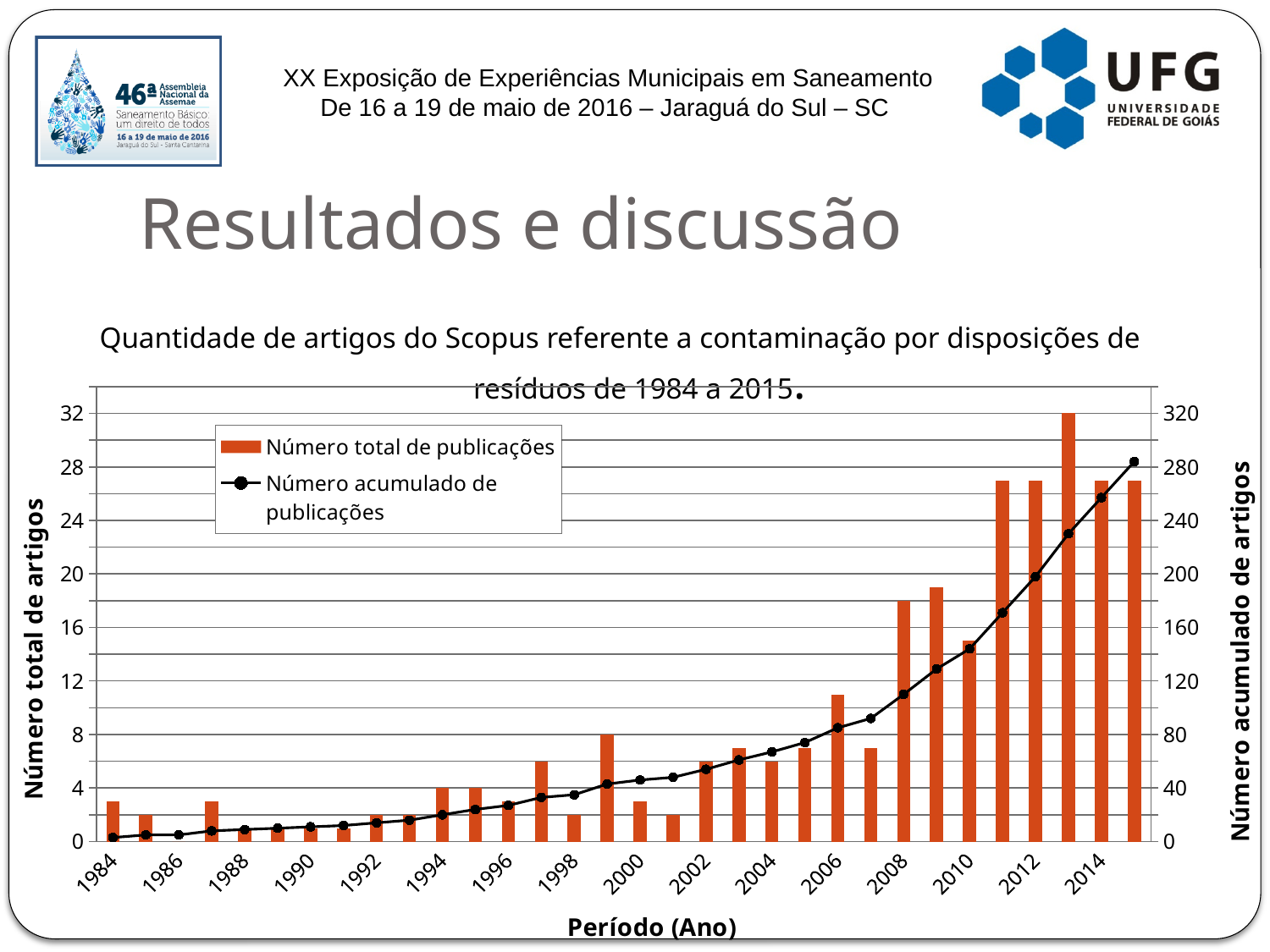
Which year has more total publications, 2012 or 2013? 2013 What is the title of the x axis? Período (Ano) How many series does the legend list? 2 Is the number of total publications in 2006 greater or less than 8? greater What is the number of total publications in 1999? 8 Which year has the highest number of total publications (tallest bar)? 2013 Does the cumulative number of publications line rise or fall from 1984 to 2015? Rises Is the cumulative number of articles (Número acumulado de publicações) in 2010 greater or less than 120? greater Is the number of total publications in 2008 greater or less than 16? greater What is the number of total publications in 2013? 32 What type of chart is shown on the slide? Combined bar and line chart What is the label of the right-hand y axis? Número acumulado de artigos